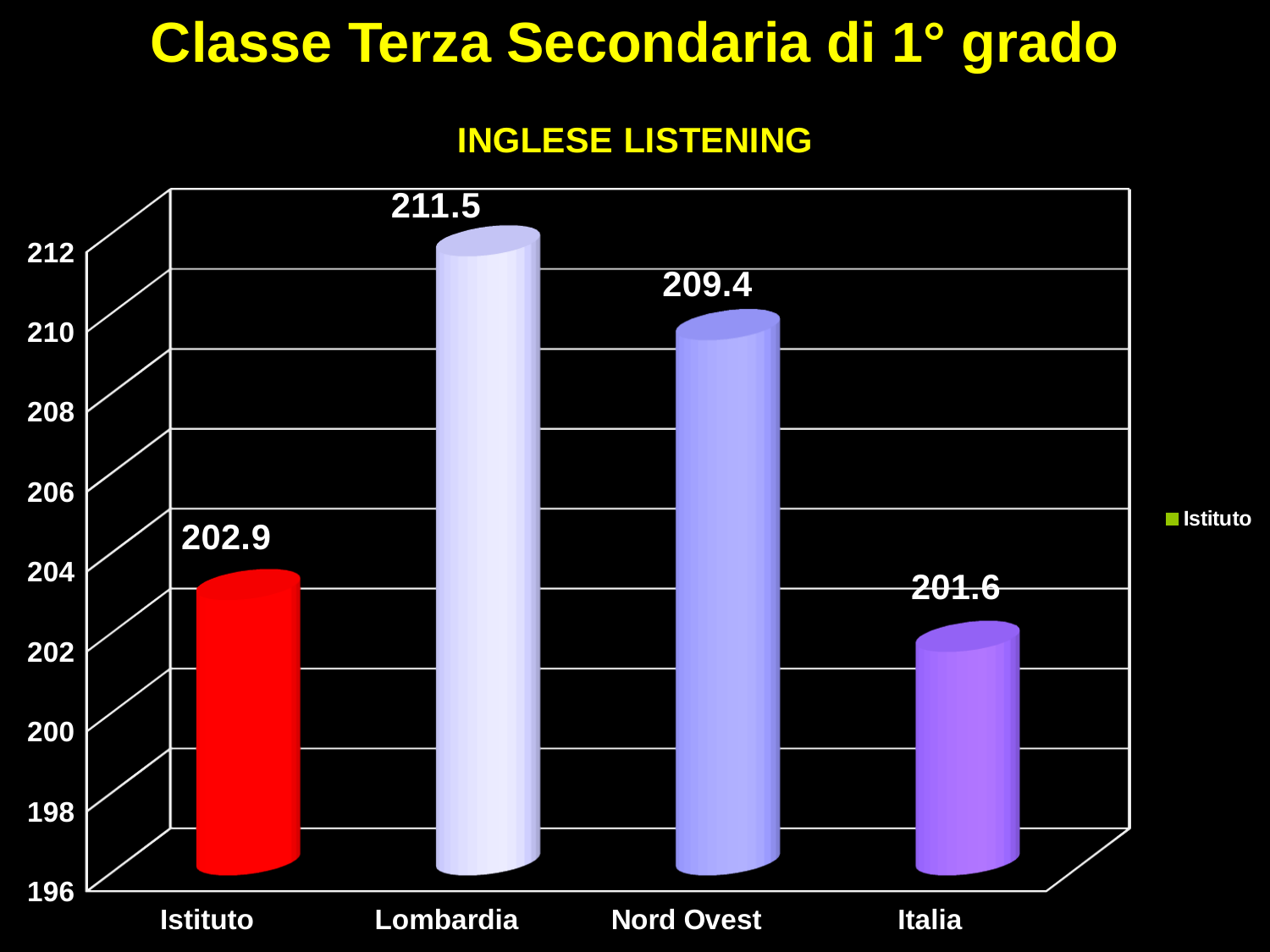
What is the value for Istituto? 202.9 What is the value for Italia? 201.6 Which category has the lowest value? Italia What kind of chart is shown on the slide? bar chart How many categories are shown on the x axis? 4 Which is larger, the value for Istituto or the value for Italia? Istituto What is the difference between the values for Nord Ovest and Italia? 7.8 What is the value for Lombardia? 211.5 What is the difference between the values for Lombardia and Istituto? 8.6 Which category has the highest value? Lombardia What is the value for Nord Ovest? 209.4 What is the title of the chart? INGLESE LISTENING